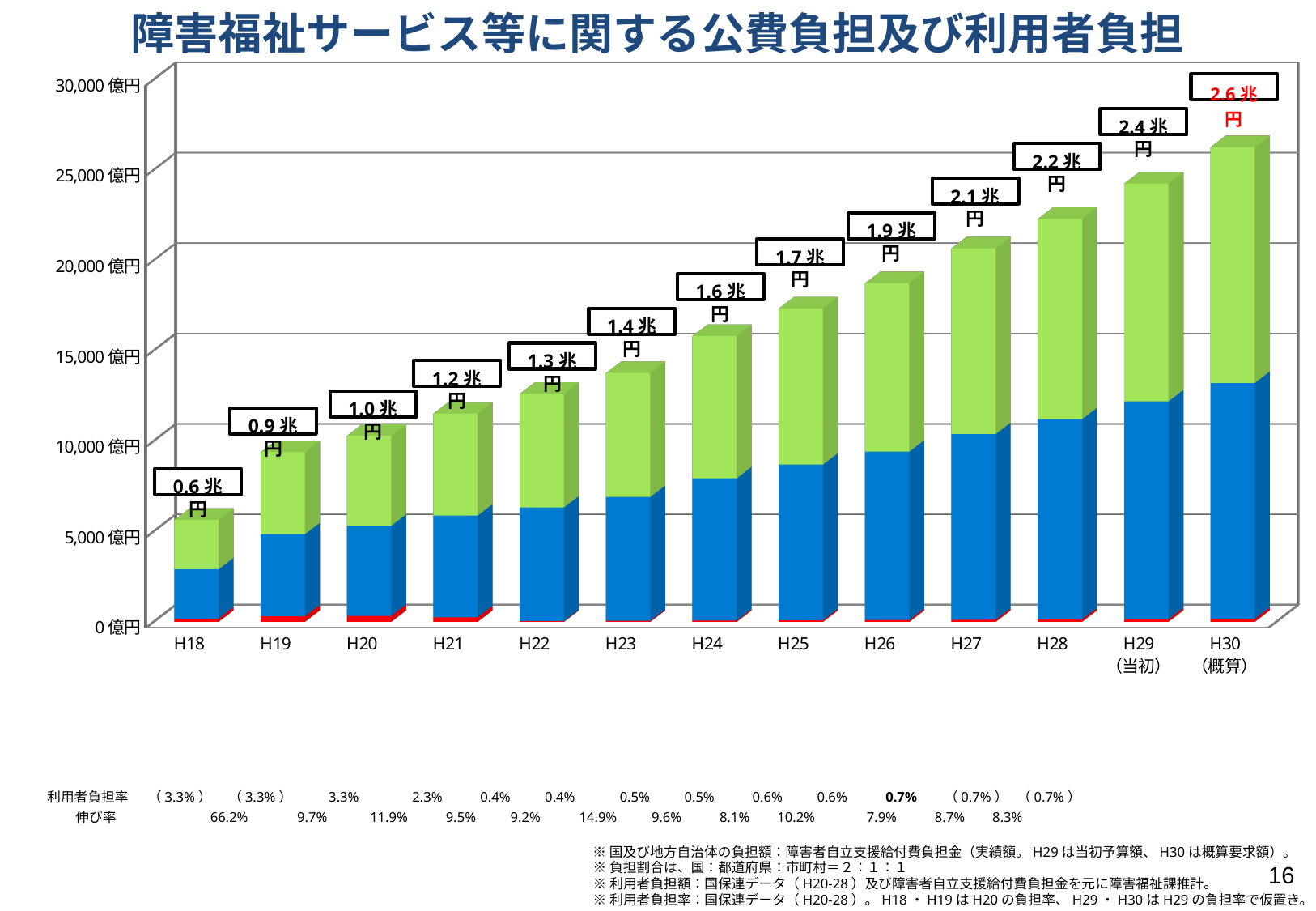
What kind of chart is shown? stacked bar chart Is the total for H30 (概算) greater or less than 25,000 億円? greater What total value is labelled above the H18 bar? 0.6兆円 Is the total for H18 greater or less than 10,000 億円? less What total value is labelled above the H30 (概算) bar? 2.6兆円 Which has the larger total, H26 or H22? H26 Which year has the lowest total? H18 What total value is labelled above the H24 bar? 1.6兆円 Which year has the highest total? H30 (概算) Do the totals rise or fall from H18 to H30? rise What is the difference between the labelled totals for H30 (概算) and H18? 2.0兆円 How many years are shown on the x axis? 13